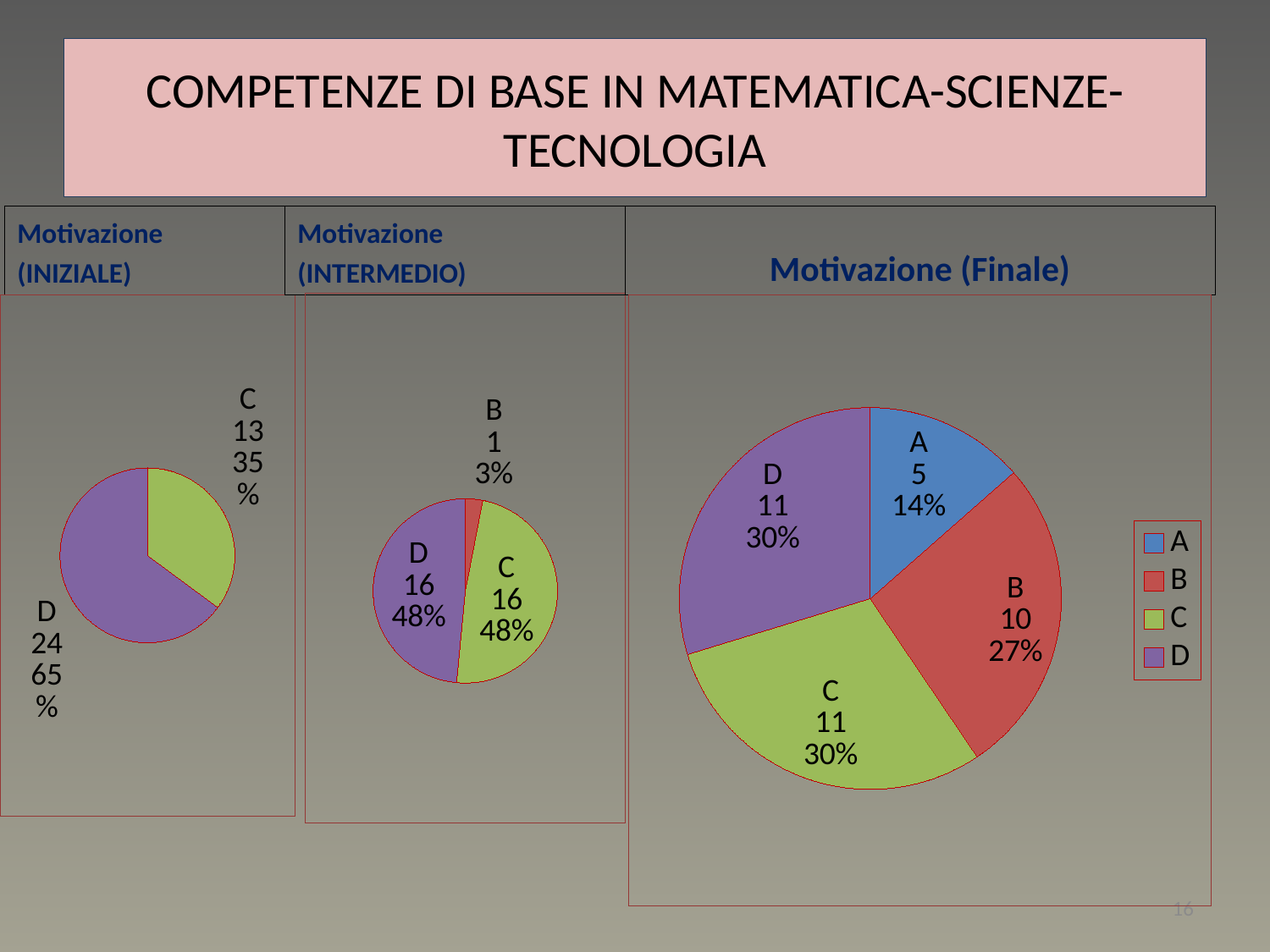
In the Motivazione (INTERMEDIO) chart, which category has the smallest slice? B In the Motivazione (Finale) chart, what is the value for B? 10 In the Motivazione (INIZIALE) chart, how many slices does the pie have? 2 In the Motivazione (INIZIALE) chart, what is the value for D? 24 In the Motivazione (Finale) chart, how many entries does the legend list? 4 In the Motivazione (Finale) chart, which category has the smallest slice? A In the Motivazione (INTERMEDIO) chart, what share of the pie does D represent? 48% In the Motivazione (INIZIALE) chart, what share of the pie does C represent? 35% In the Motivazione (INTERMEDIO) chart, what is the value for B? 1 In the Motivazione (Finale) chart, what is the difference between the values for B and A? 5 In the Motivazione (Finale) chart, what share of the pie does A represent? 14% What kind of chart is the Motivazione (Finale) chart? Pie chart